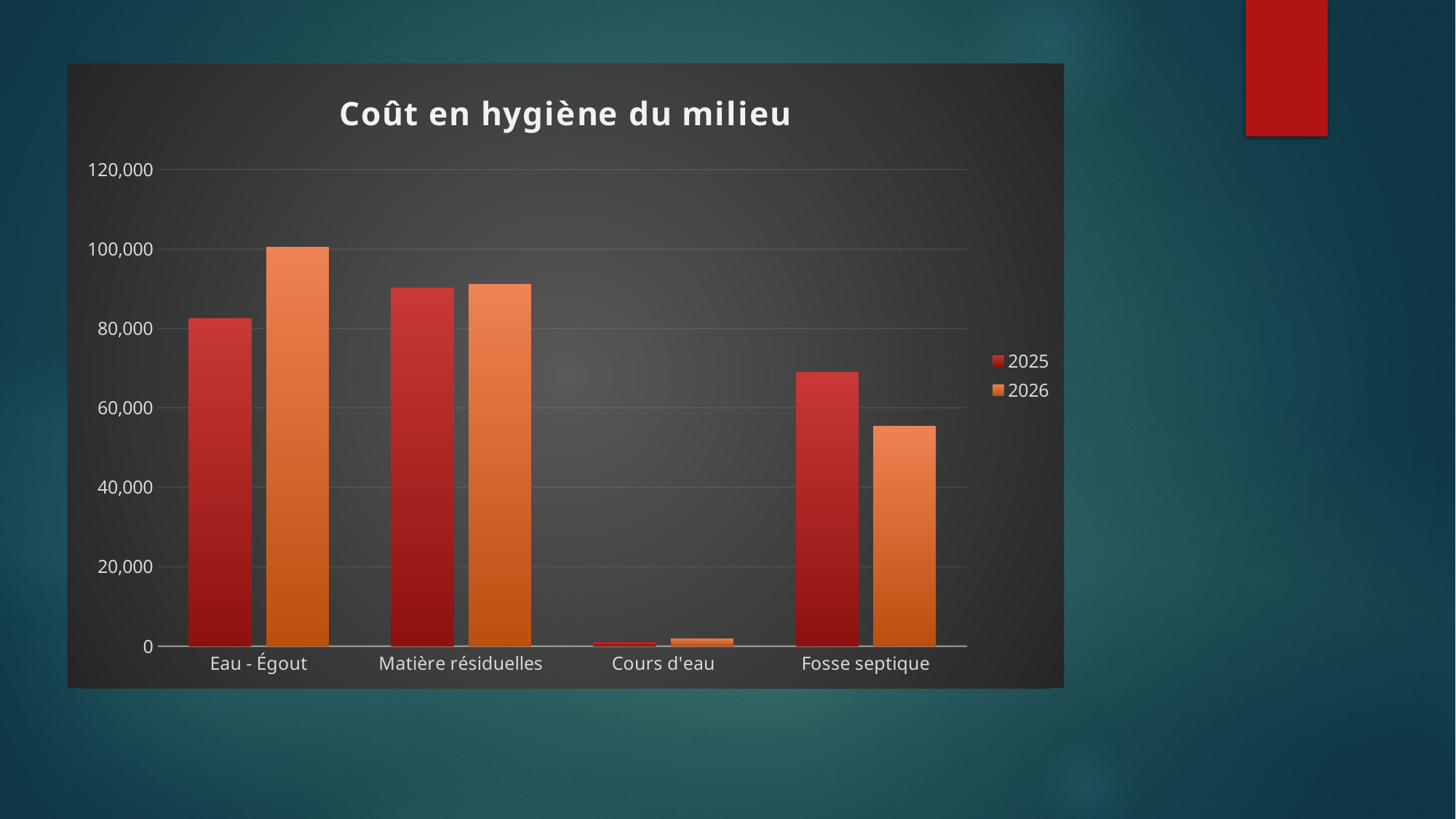
Which category has the lowest value for the 2025 series? Cours d'eau Which category has the highest value for the 2026 series? Eau - Égout Is the 2025 value for Eau - Égout greater or less than 80,000? greater For Fosse septique, which series has the larger value, 2025 or 2026? 2025 How many categories are shown on the x axis? 4 What is the title of the chart? Coût en hygiène du milieu For Eau - Égout, which series has the larger value, 2025 or 2026? 2026 How many series does the legend list? 2 Is the 2026 value for Fosse septique greater or less than 60,000? less Which series is shown in orange in the legend? 2026 What kind of chart is shown on the slide? bar chart Which category has the highest value for the 2025 series? Matière résiduelles